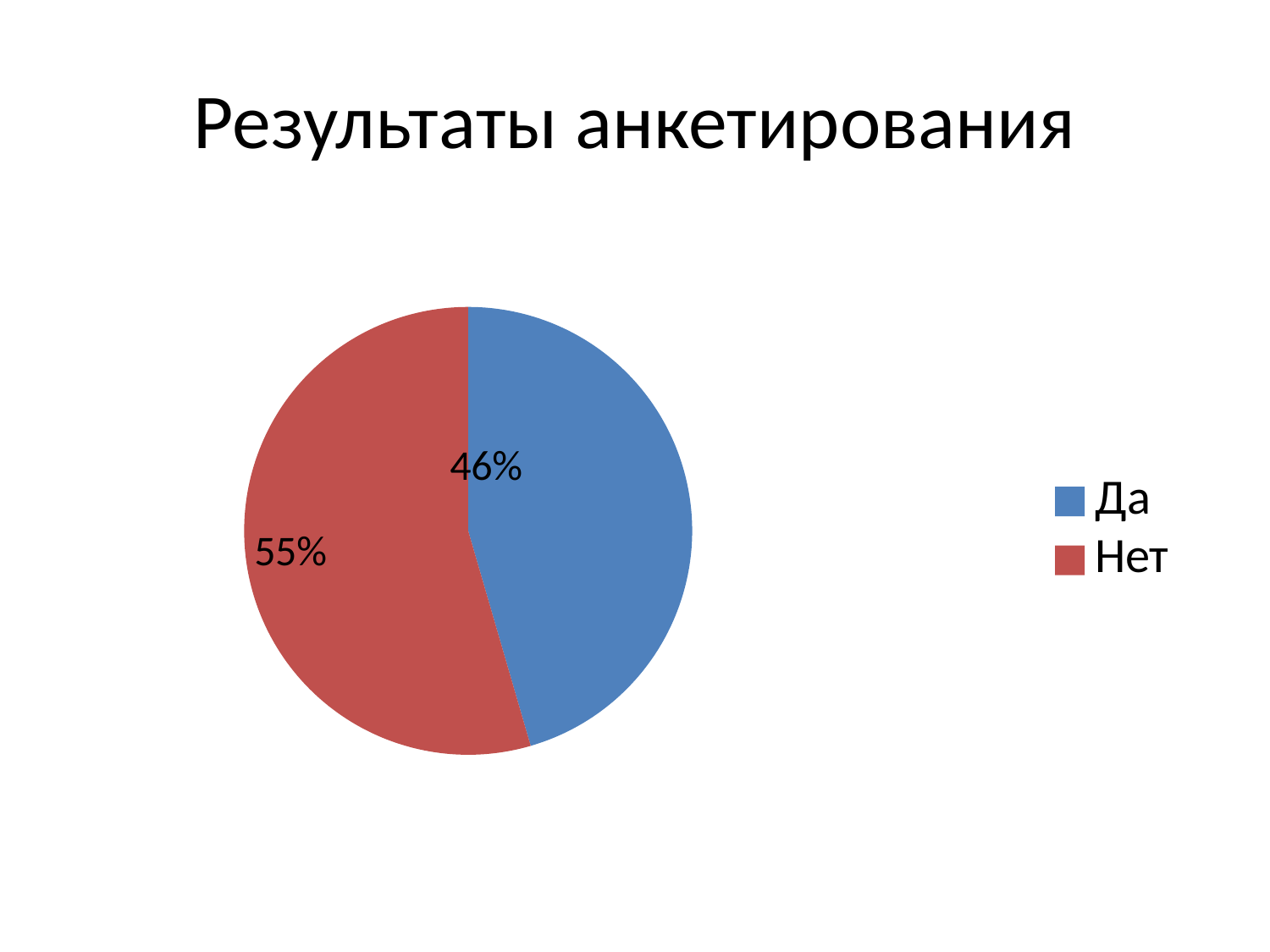
What is the title of the slide? Результаты анкетирования What is the value for Нет? 55% How many entries does the legend list? 2 What is the difference between the share for Нет and the share for Да? 9% How many categories does the pie chart have? 2 What kind of chart is shown on the slide? pie chart Which is larger, the share for Да or the share for Нет? Нет Which category has the largest share of the pie? Нет Which category has the smallest share of the pie? Да What is the value for Да? 46% What colour is the slice for Нет? red